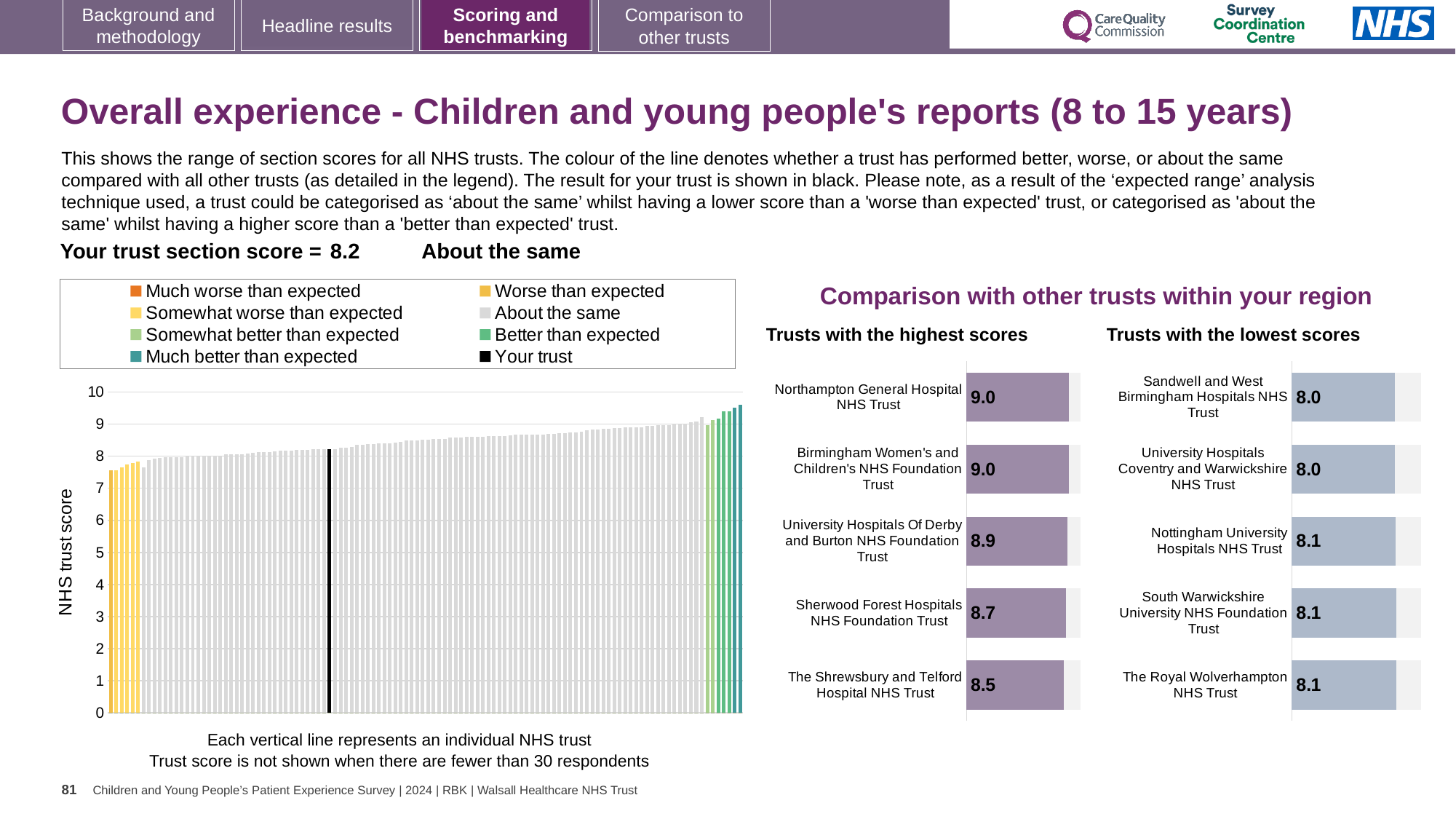
How many entries does the legend of the main 'NHS trust score' chart list? 8 In the 'Trusts with the lowest scores' chart, what is the score for Sandwell and West Birmingham Hospitals NHS Trust? 8.0 In the main 'NHS trust score' chart, is the value of the tallest bar greater or less than 9? greater In the main 'NHS trust score' chart on the left, what kind of chart is it? Bar chart In the 'Trusts with the lowest scores' chart, what is the score for Nottingham University Hospitals NHS Trust? 8.1 In the 'Trusts with the highest scores' chart, which trust has the lowest score? The Shrewsbury and Telford Hospital NHS Trust How many trusts are listed in the 'Trusts with the lowest scores' chart? 5 In the 'Trusts with the highest scores' chart, what is the score for Sherwood Forest Hospitals NHS Foundation Trust? 8.7 In the 'Trusts with the highest scores' chart, which has the larger score: University Hospitals Of Derby and Burton NHS Foundation Trust or Sherwood Forest Hospitals NHS Foundation Trust? University Hospitals Of Derby and Burton NHS Foundation Trust In the 'Trusts with the highest scores' chart, what is the score for Northampton General Hospital NHS Trust? 9.0 In the 'Trusts with the highest scores' chart, what is the difference between the scores of Northampton General Hospital NHS Trust and The Shrewsbury and Telford Hospital NHS Trust? 0.5 In the main 'NHS trust score' chart, what colour is used to show 'Your trust'? Black